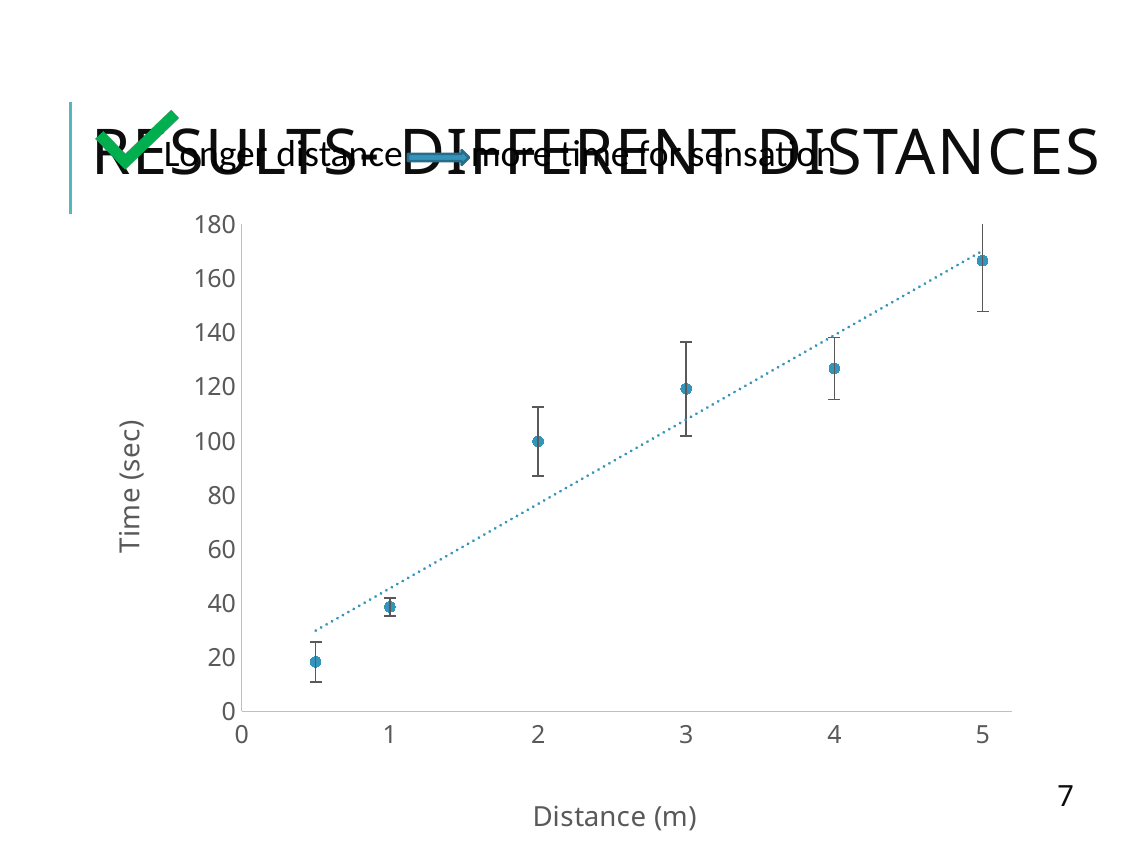
What kind of chart is shown on the slide? scatter chart How many data points are plotted on the chart? 6 Does the time rise or fall as distance increases along the x axis? rise At which distance is the time highest? 5 m At which distance is the time lowest? 0.5 m What is the label of the x axis? Distance (m) Is the time at a distance of 4 m greater or less than 140? less Which has the larger time, the point at 2 m or the point at 4 m? 4 m Is the time at a distance of 1 m greater or less than 60? less Is the time at a distance of 5 m greater or less than 160? greater What is the label of the y axis? Time (sec)